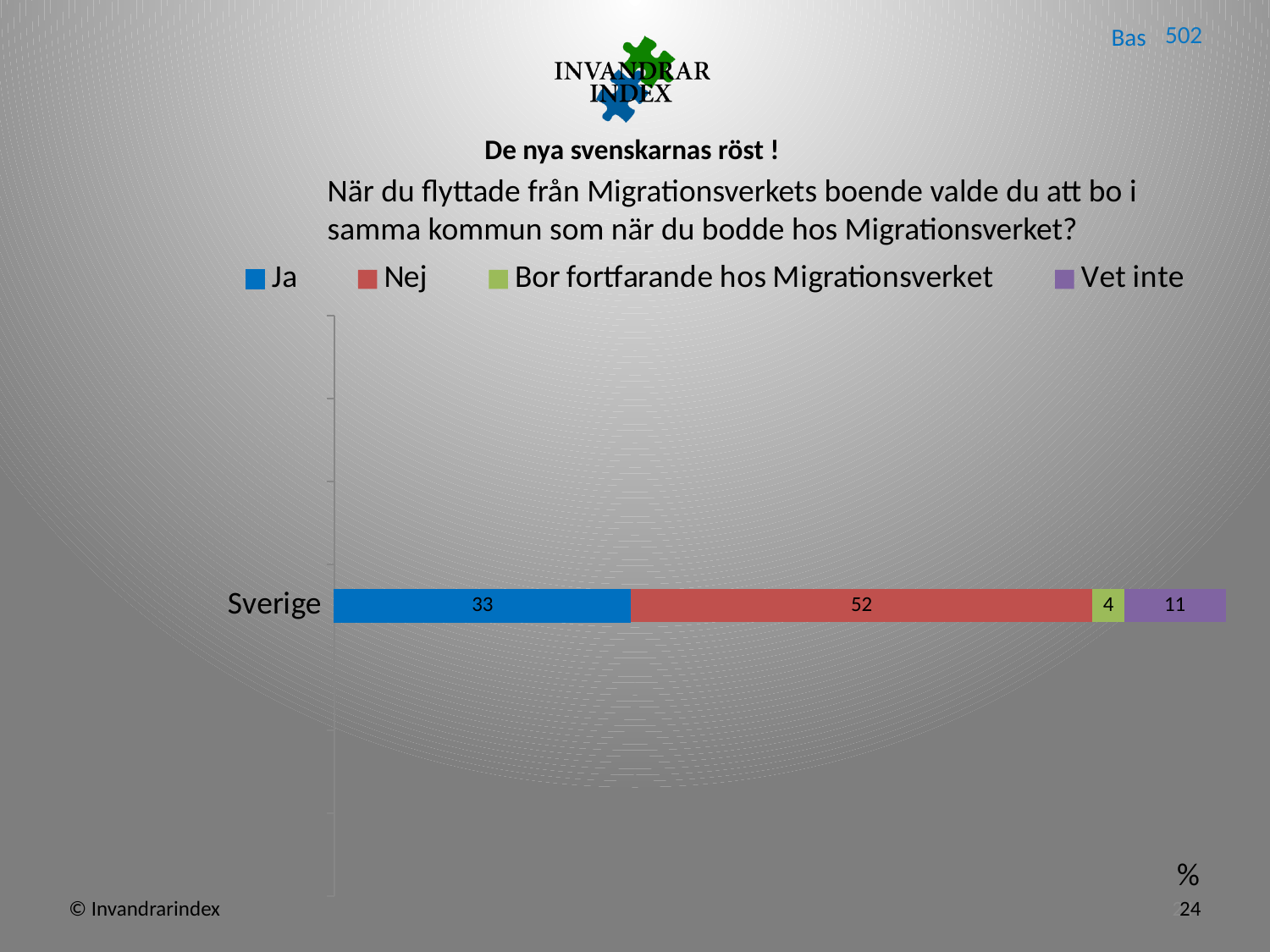
How many series does the legend list? 4 How many categories are plotted on the chart? 1 What is the value for "Bor fortfarande hos Migrationsverket" in the Sverige bar? 4 What is the value for "Vet inte" in the Sverige bar? 11 Which series has the lowest value in the Sverige bar? Bor fortfarande hos Migrationsverket Which is larger for Sverige, "Vet inte" or "Bor fortfarande hos Migrationsverket"? Vet inte What is the difference between the "Nej" and "Ja" values for Sverige? 19 What is the value for "Ja" in the Sverige bar? 33 What is the total of the stacked bar for Sverige? 100 Which series has the highest value in the Sverige bar? Nej What kind of chart is shown on the slide? Stacked bar chart What is the value for "Nej" in the Sverige bar? 52